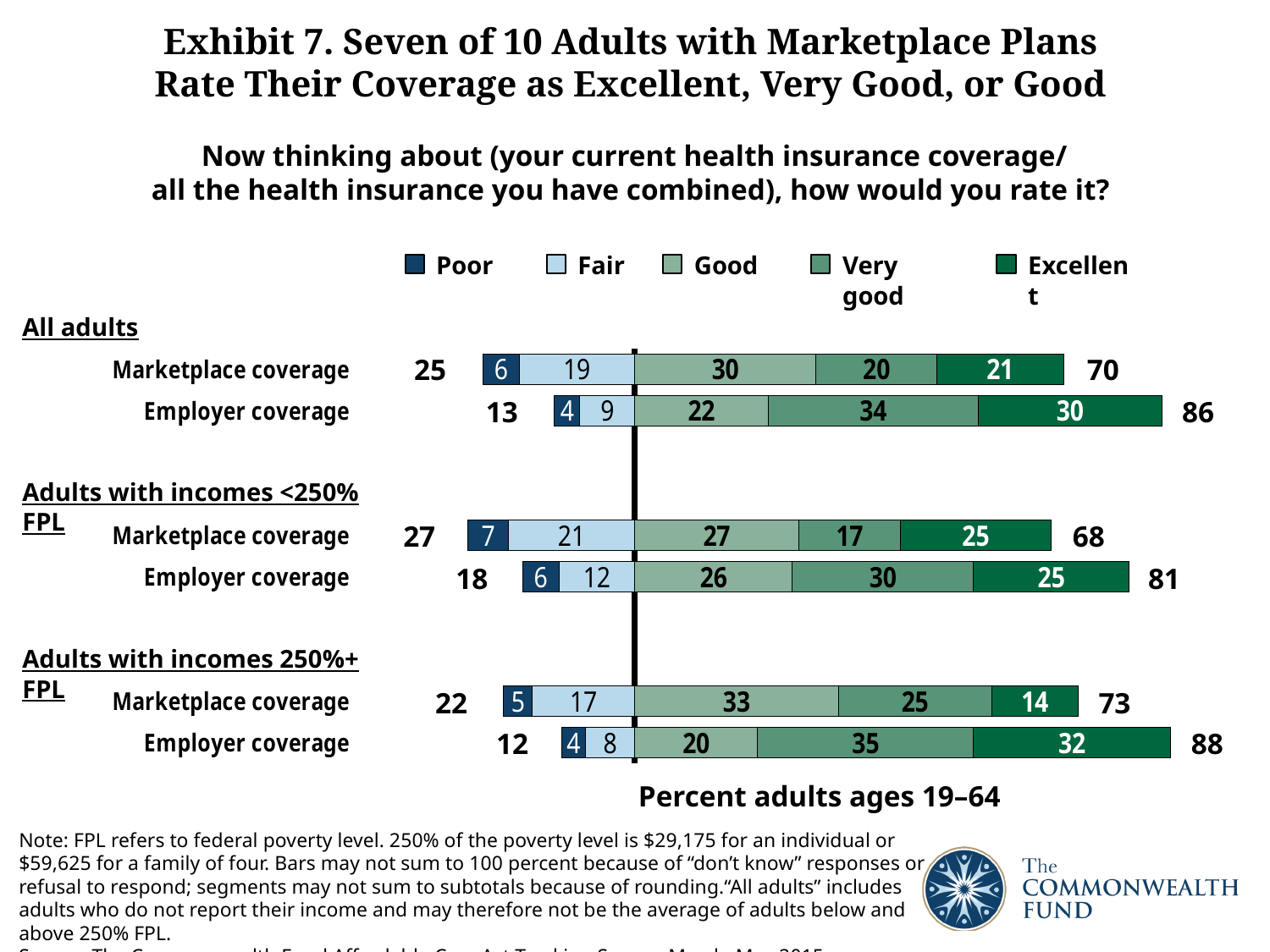
What is the difference between the Excellent share for all adults with employer coverage and all adults with marketplace coverage? 9 What is the combined Poor or Fair subtotal shown for adults with incomes <250% FPL and marketplace coverage? 27 What kind of chart is shown on the slide? Stacked bar chart How many series does the legend list? 5 Which group has the highest Excellent, Very good, or Good subtotal? Adults with incomes 250%+ FPL, employer coverage (88) What percentage of all adults with marketplace coverage rate their coverage as Good? 30 What is the combined Excellent, Very good, or Good subtotal shown for all adults with marketplace coverage? 70 What percentage of all adults with employer coverage rate their coverage as Very good? 34 What percentage of adults with incomes 250%+ FPL and employer coverage rate their coverage as Poor? 4 Which is larger: the Fair share for adults with incomes <250% FPL with marketplace coverage or with employer coverage? Marketplace coverage (21) Which group has the lowest Excellent, Very good, or Good subtotal? Adults with incomes <250% FPL, marketplace coverage (68) What percentage of adults with incomes <250% FPL and marketplace coverage rate their coverage as Excellent? 25